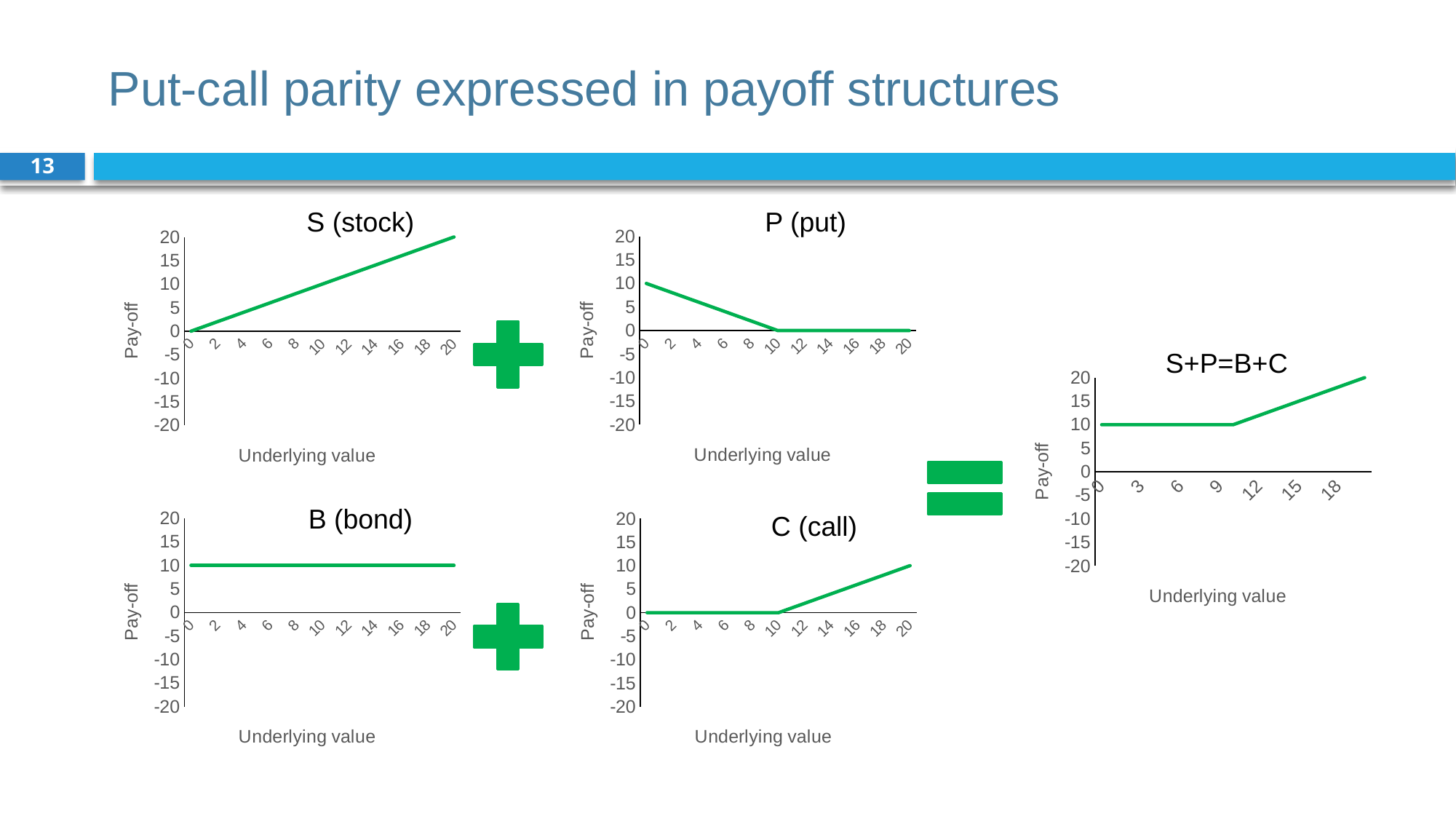
In the 'S+P=B+C' chart, is the pay-off at an underlying value of 18 greater or less than 15? greater How many charts are shown on the slide? 5 In the 'B (bond)' chart, what is the pay-off across all underlying values? 10 In the 'C (call)' chart, what is the pay-off when the underlying value is 20? 10 In the 'S+P=B+C' chart, what is the pay-off when the underlying value is 0? 10 In the 'P (put)' chart, does the pay-off rise or fall as the underlying value goes from 0 to 10? fall In the 'S (stock)' chart, is the pay-off at an underlying value of 16 greater or less than 10? greater In the 'C (call)' chart, what is the pay-off when the underlying value is 5? 0 In the 'S (stock)' chart, does the pay-off rise or fall as the underlying value increases? rise In the 'P (put)' chart, what is the pay-off when the underlying value is 0? 10 What is the x-axis label on the 'B (bond)' chart? Underlying value What kind of chart is the 'S (stock)' chart? line chart